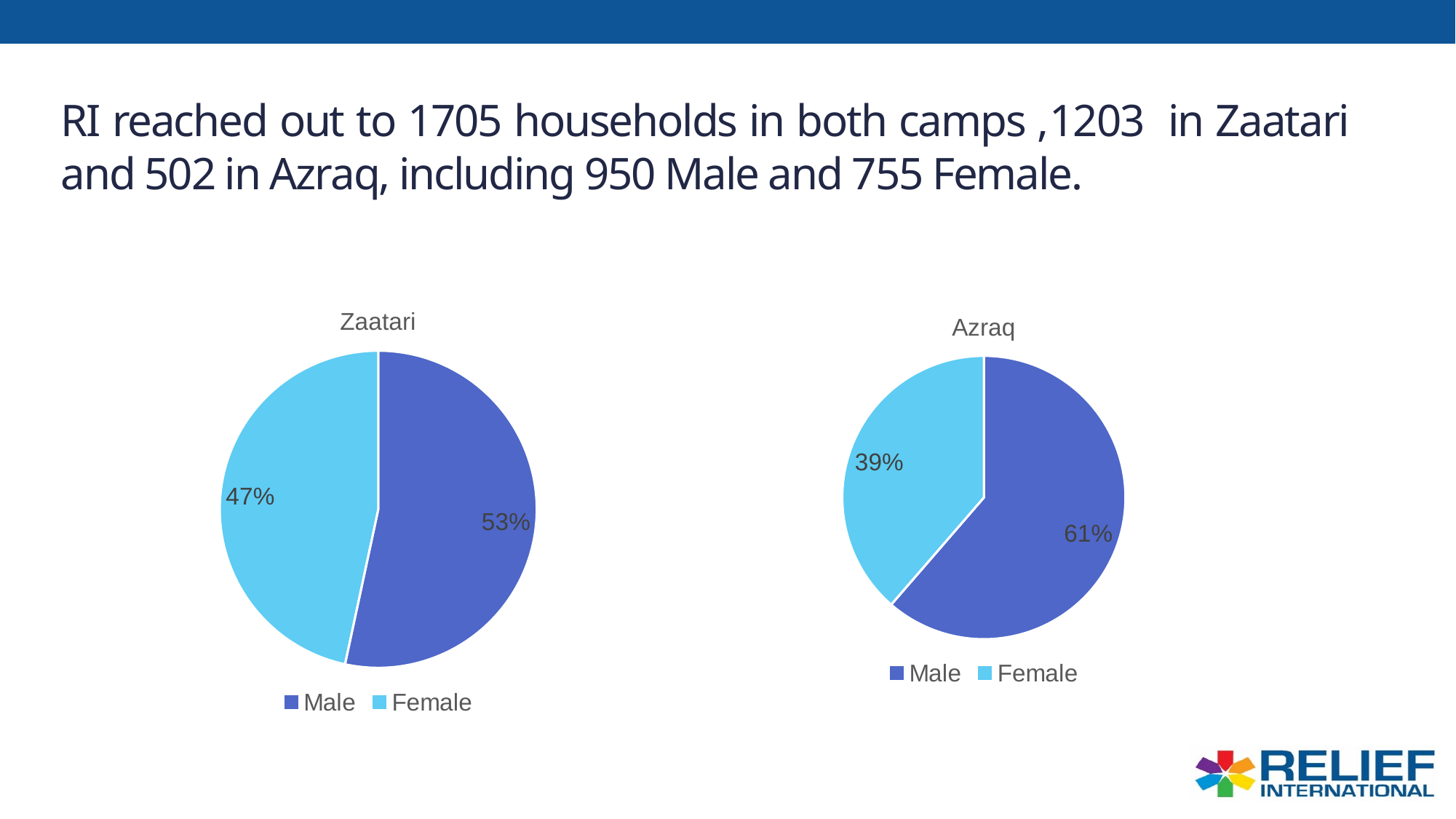
In the Zaatari chart, what is the difference between the Male and Female shares? 6% What kind of chart is the Zaatari chart? Pie chart In the Azraq chart, what share of the pie is Male? 61% What entries does the legend of the Azraq chart list? Male, Female In the Zaatari chart, which slice is the smallest? Female In the Azraq chart, what is the difference between the Male and Female shares? 22% In the Azraq chart, which slice is the largest? Male In the Azraq chart, what share of the pie is Female? 39% In the Zaatari chart, what share of the pie is Female? 47% Which is larger: the Male share in Azraq or the Male share in Zaatari? Azraq How many slices does the Azraq chart have? 2